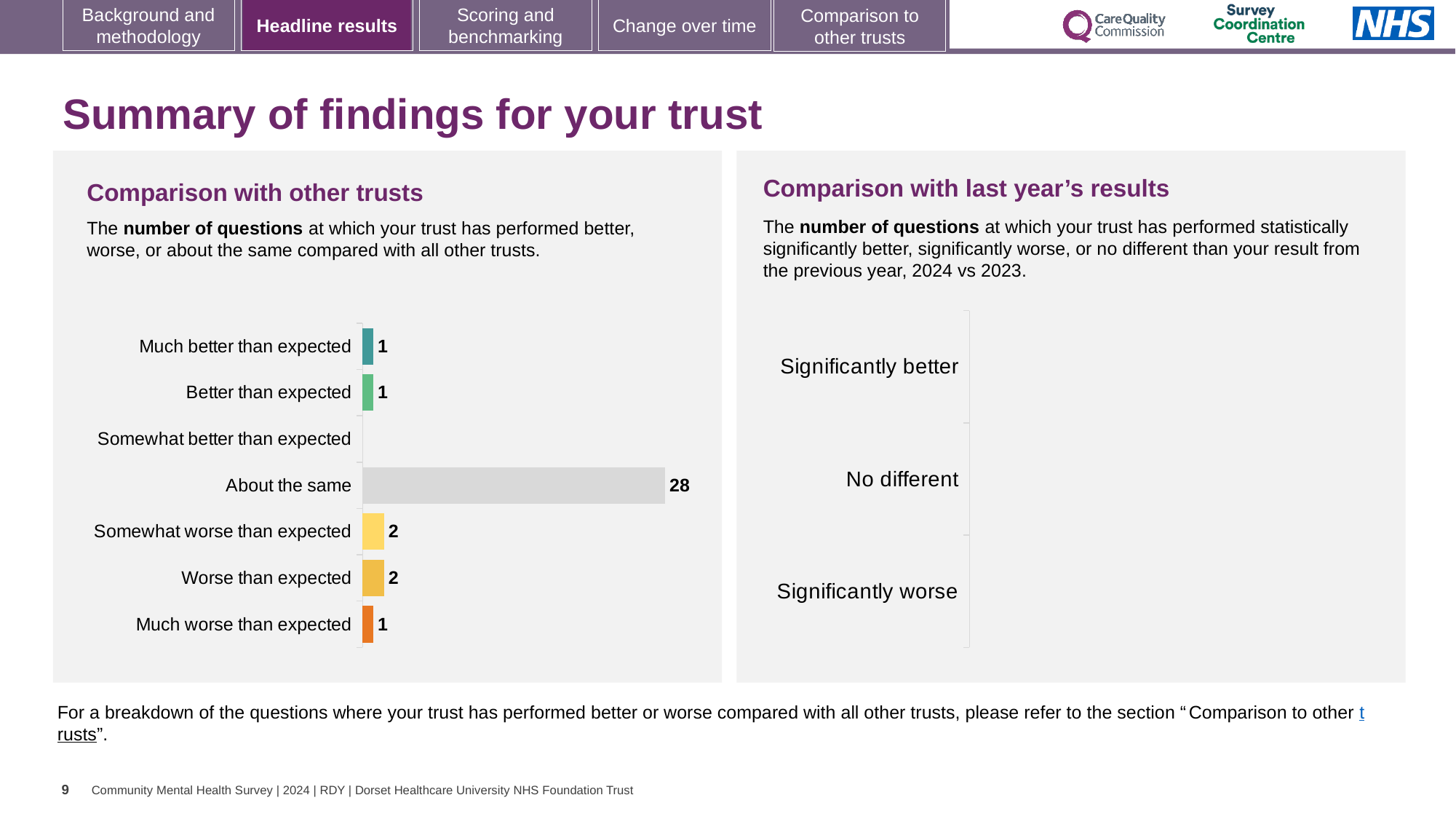
What kind of chart is the 'Comparison with other trusts' chart? Bar chart In the 'Comparison with other trusts' chart, how many categories are listed on the axis? 7 In the 'Comparison with other trusts' chart, what is the value for 'Much better than expected'? 1 In the 'Comparison with other trusts' chart, what is the value for 'Much worse than expected'? 1 In the 'Comparison with other trusts' chart, which is larger: 'Somewhat worse than expected' or 'Better than expected'? Somewhat worse than expected In the 'Comparison with last year's results' chart, how many categories are listed on the axis? 3 In the 'Comparison with other trusts' chart, what is the value for 'Worse than expected'? 2 In the 'Comparison with other trusts' chart, what colour is the bar for 'About the same'? Grey In the 'Comparison with other trusts' chart, what is the difference between 'About the same' and 'Worse than expected'? 26 In the 'Comparison with other trusts' chart, which category has the highest value? About the same In the 'Comparison with other trusts' chart, what is the value for 'Somewhat worse than expected'? 2 In the 'Comparison with other trusts' chart, what is the value for 'About the same'? 28